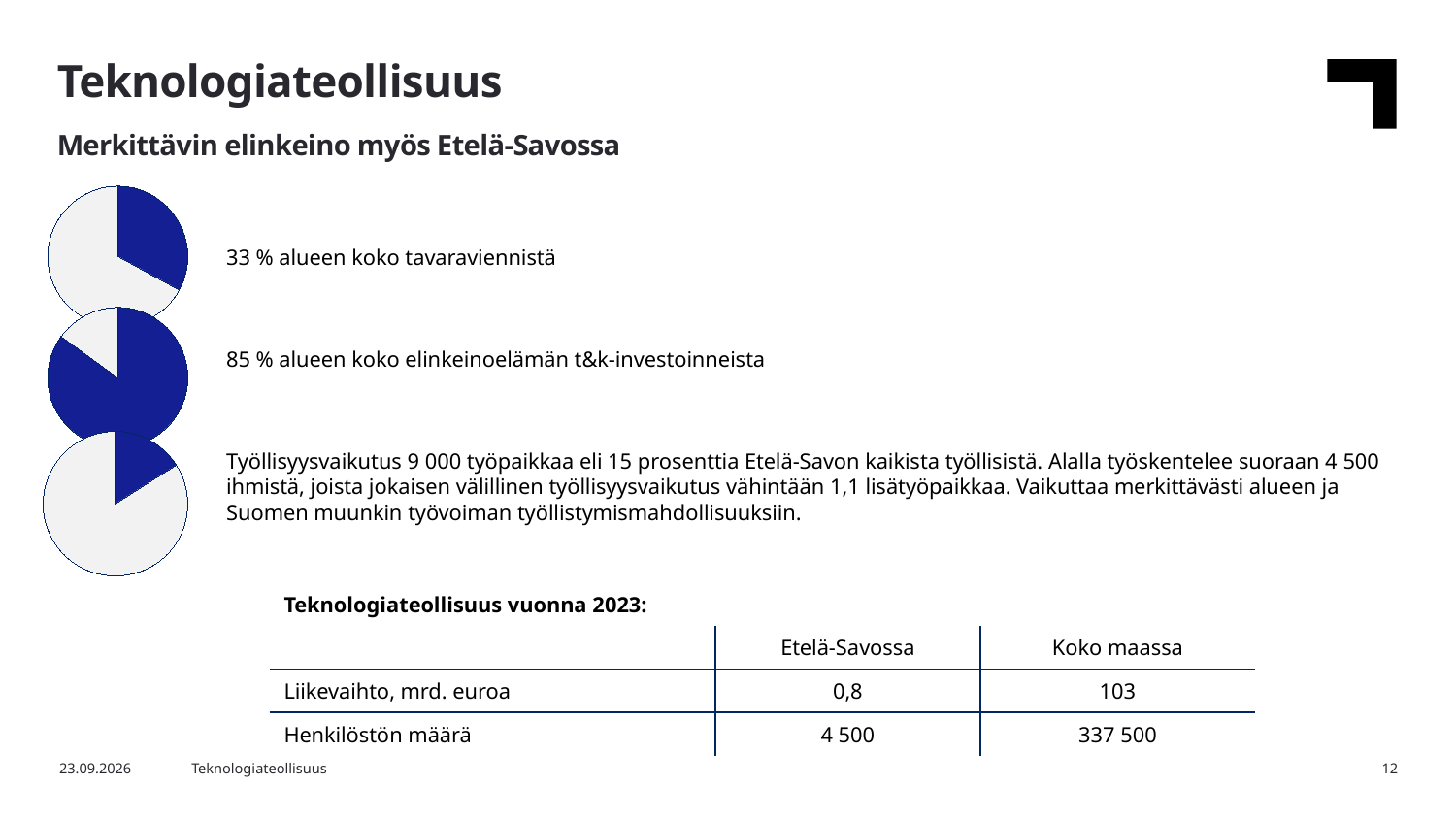
In the middle pie chart, what share of the region's business R&D investments does the blue slice represent? 85 % How many pie charts are on the slide? 3 Which of the three pie charts has the largest blue slice? the middle pie chart (85 %) Is the blue slice in the top pie chart larger or smaller than the blue slice in the bottom pie chart? larger What is the difference in percentage points between the blue slice of the middle pie chart and the blue slice of the top pie chart? 52 Is the blue slice in the top pie chart greater or less than 50 % of the pie? less In the bottom pie chart, what share of all employed people in Etelä-Savo does the blue slice represent? 15 prosenttia How many slices does each pie chart on the slide have? 2 Which of the three pie charts has the smallest blue slice? the bottom pie chart (15 prosenttia) In the top pie chart, what share of the region's total goods exports does the blue slice represent? 33 % What kind of chart is shown at the top left of the slide? pie chart Is the blue slice in the middle pie chart greater or less than 50 % of the pie? greater